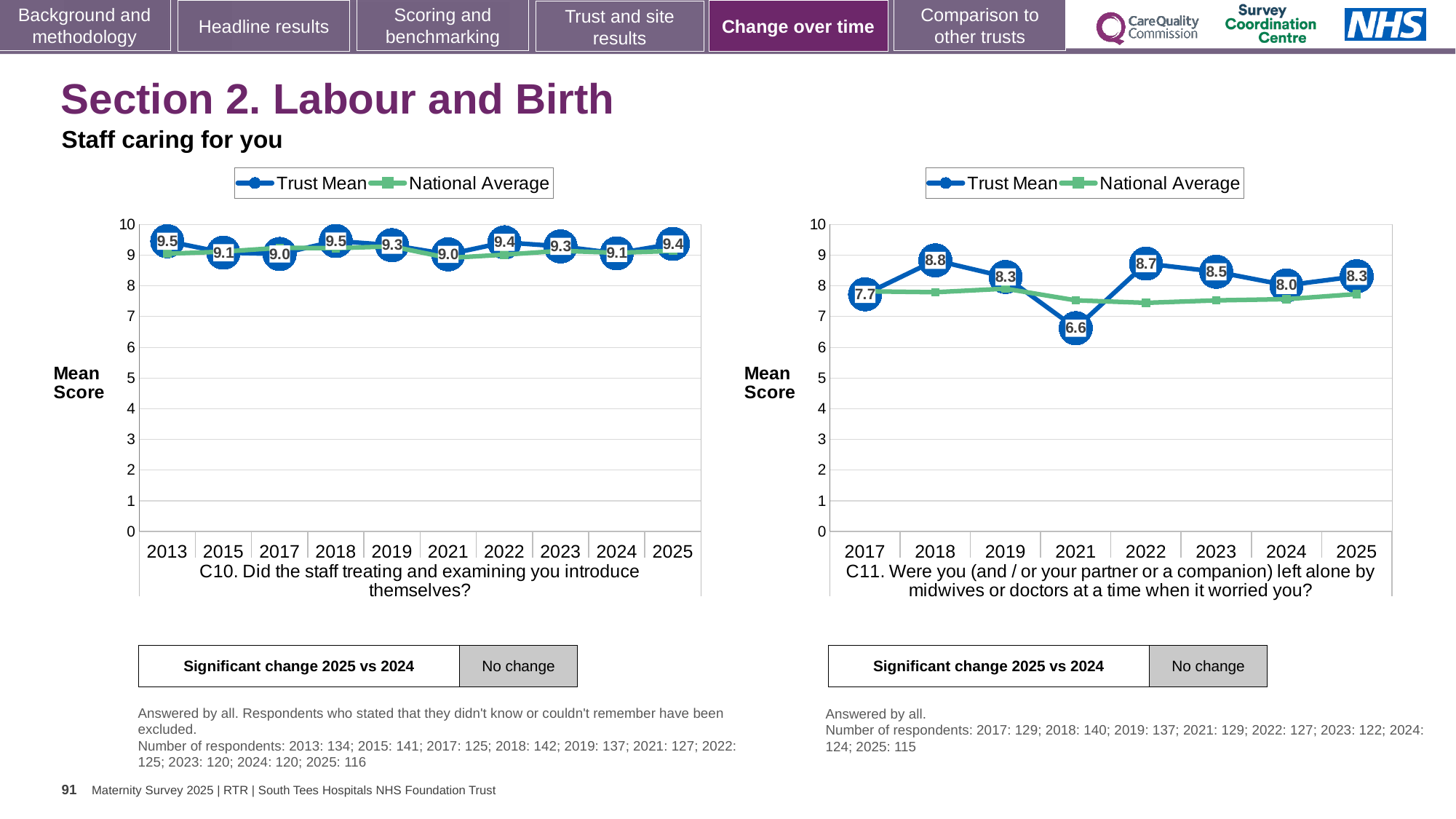
In the C10 chart on the left, what is the difference between the Trust Mean for 2025 and for 2024? 0.3 In the C11 chart on the right, what is the Trust Mean for 2021? 6.6 How many series does the legend of the C11 chart on the right list? 2 In the C11 chart on the right, which is larger, the Trust Mean for 2022 or for 2024? 2022 In the C10 chart on the left, what is the Trust Mean for 2013? 9.5 In the C11 chart on the right, is the National Average for 2021 greater or less than 7? greater In the C10 chart on the left, what is the Trust Mean for 2025? 9.4 In the C11 chart on the right, which year has the highest Trust Mean? 2018 What kind of chart is the C10 chart on the left? Line chart In the C11 chart on the right, what is the difference between the Trust Mean for 2018 and for 2021? 2.2 How many years are plotted in the C10 chart on the left? 10 In the C11 chart on the right, which year has the lowest Trust Mean? 2021